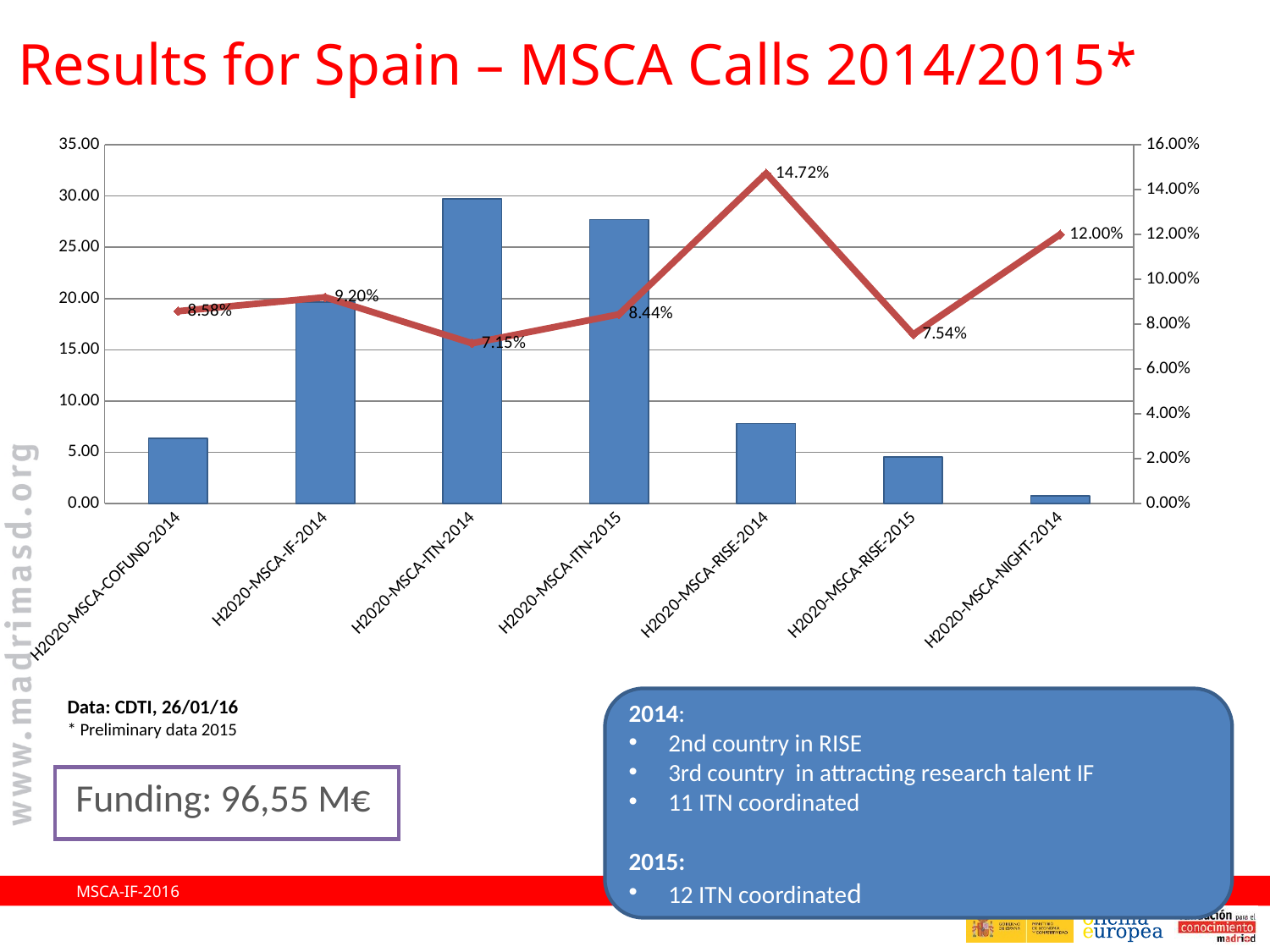
Which category has the shortest bar? H2020-MSCA-NIGHT-2014 How many categories are shown on the x axis? 7 What is the percentage value shown for H2020-MSCA-RISE-2014? 14.72% Which category has the tallest bar? H2020-MSCA-ITN-2014 What is the percentage value shown for H2020-MSCA-COFUND-2014? 8.58% Which category has the highest percentage value on the line? H2020-MSCA-RISE-2014 Is the bar value for H2020-MSCA-RISE-2015 greater or less than 5.00? less What is the percentage value shown for H2020-MSCA-NIGHT-2014? 12.00% Which category has the lowest percentage value on the line? H2020-MSCA-ITN-2014 What is the difference between the percentage values for H2020-MSCA-RISE-2014 and H2020-MSCA-RISE-2015? 7.18% What is the percentage value shown for H2020-MSCA-ITN-2014? 7.15% Is the bar value for H2020-MSCA-IF-2014 greater or less than 15.00? greater